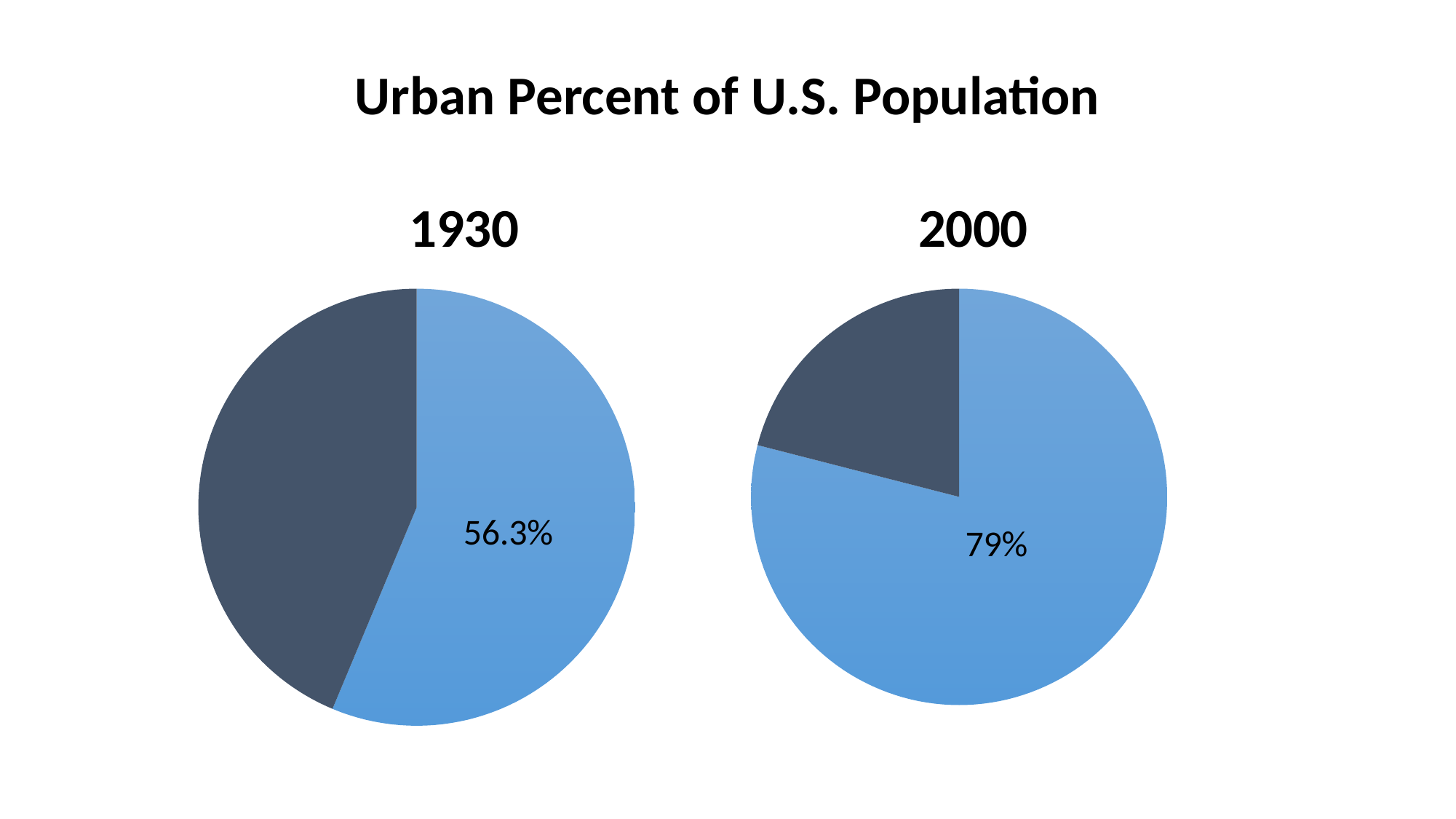
What kind of chart is used for the 1930 data? pie chart What is the title of the slide's charts? Urban Percent of U.S. Population In the 1930 pie chart, is the labelled slice greater or less than 50%? greater By how many percentage points does the labelled urban share in the 2000 pie chart exceed that in the 1930 pie chart? 22.7 Does the urban percentage rise or fall from the 1930 chart to the 2000 chart? rise In the 2000 pie chart, is the light blue slice larger or smaller than the dark slice? larger How many pie charts are on the slide? 2 In the 1930 pie chart, what percentage is shown for the light blue slice? 56.3% Which year is shown above the left pie chart? 1930 Which year's pie chart shows the larger urban percentage, 1930 or 2000? 2000 In the 2000 pie chart, what percentage is shown for the light blue slice? 79% How many slices does each pie chart have? 2